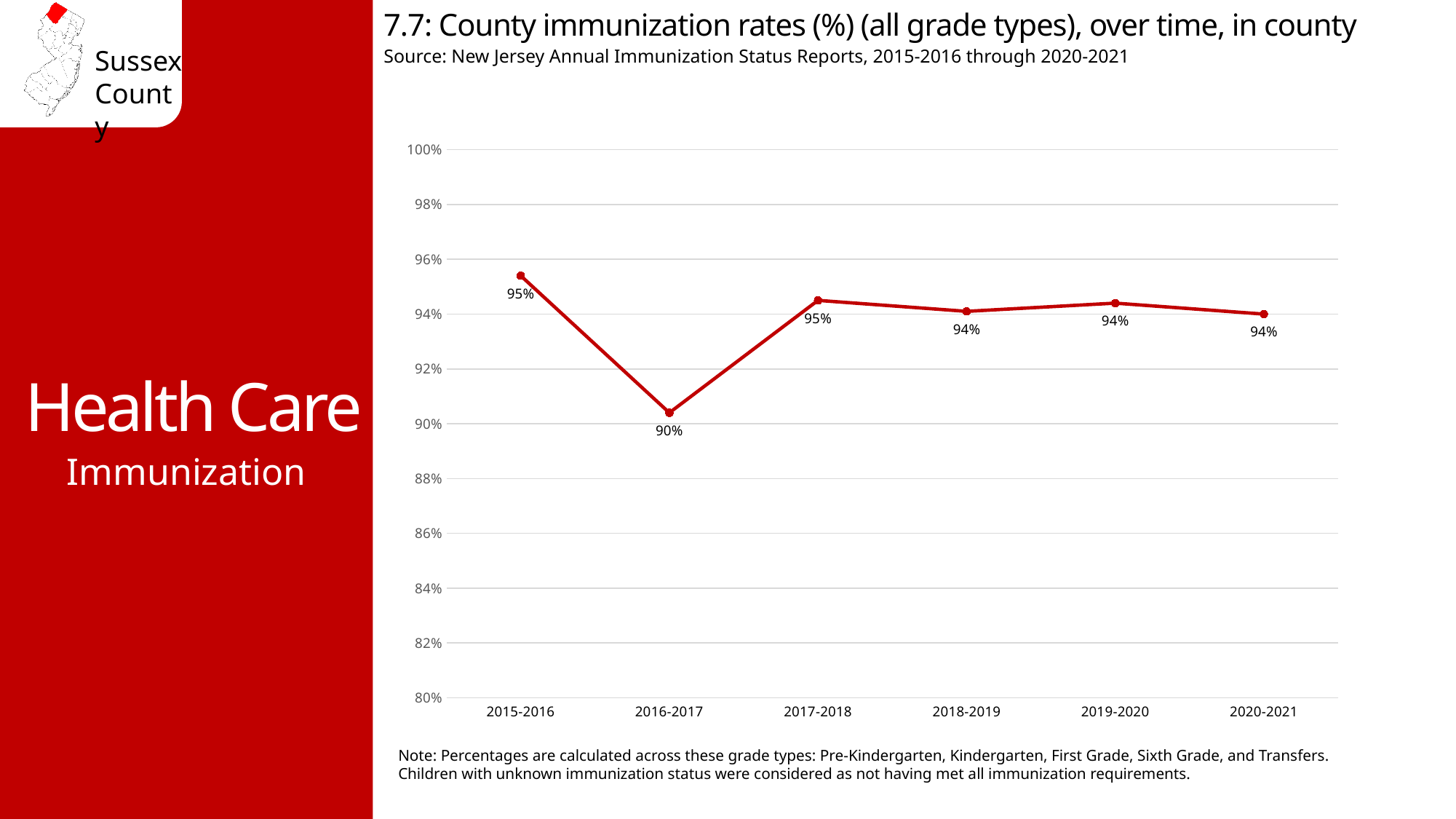
Is the immunization rate for 2018-2019 greater or less than 92%? greater Which year had a higher immunization rate, 2016-2017 or 2017-2018? 2017-2018 How many school years are plotted on the chart? 6 Between 2015-2016 and 2016-2017, did the immunization rate rise or fall? Fall What was the county immunization rate in 2015-2016? 95% What was the county immunization rate in 2016-2017? 90% What is the difference between the immunization rate in 2015-2016 and in 2016-2017? 5 percentage points What kind of chart is shown on the slide? Line chart Is the immunization rate for 2016-2017 greater or less than 92%? less What is the source cited for the chart data? New Jersey Annual Immunization Status Reports, 2015-2016 through 2020-2021 What was the county immunization rate in 2020-2021? 94% Which school year had the lowest county immunization rate? 2016-2017